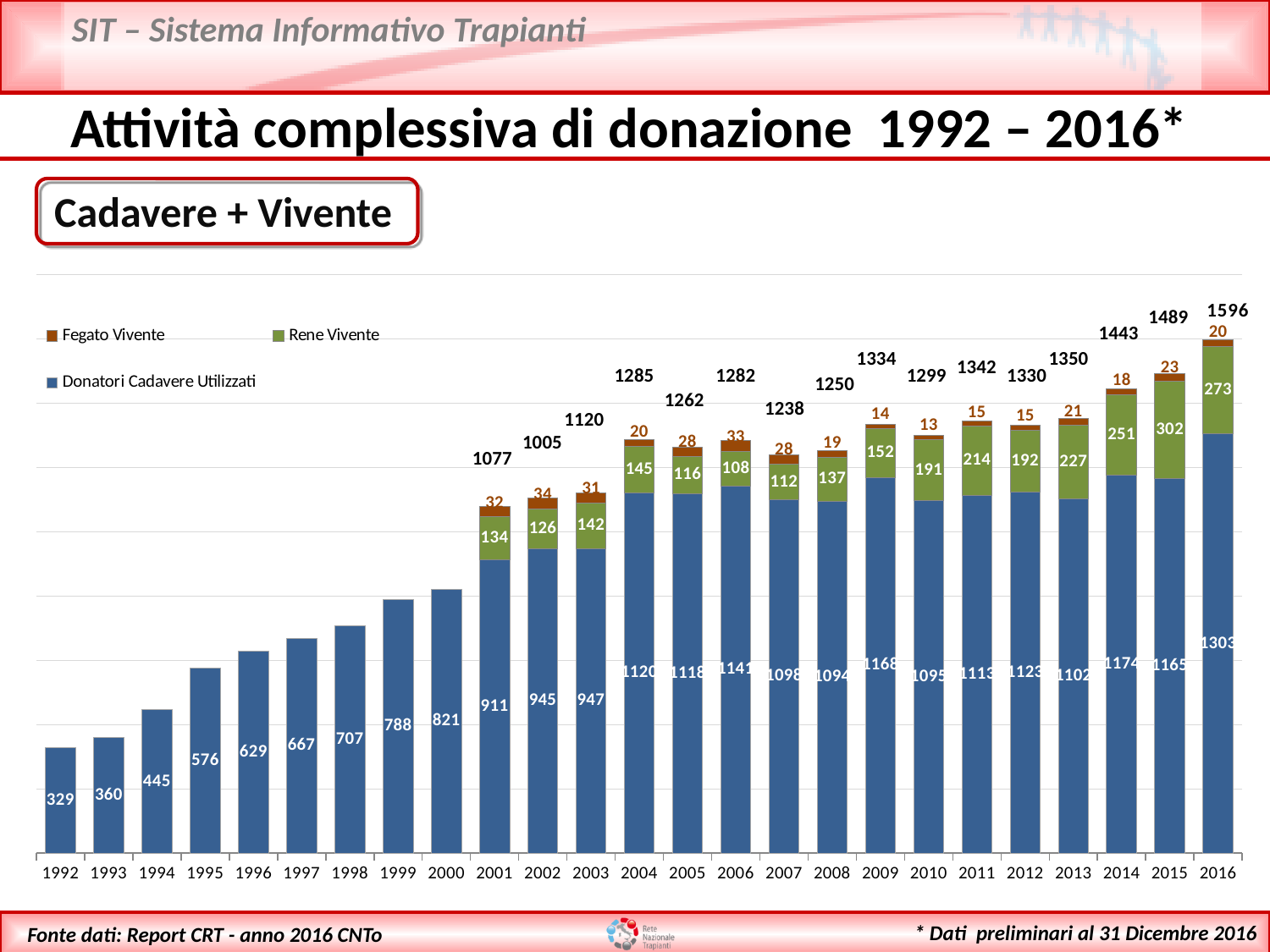
How many years are shown on the x axis? 25 What is the value of Rene Vivente in 2015? 302 What is the difference between the Donatori Cadavere Utilizzati values in 2016 and 2015? 138 Which year has the highest total shown above the bars? 2016 Do the Donatori Cadavere Utilizzati values rise or fall from 1992 to 2000? Rise What is the total shown for the 2014 bar? 1443 What type of chart is shown on the slide? Stacked bar chart Which is larger, the Rene Vivente value in 2014 or in 2016? 2016 What is the value of Fegato Vivente in 2013? 21 What is the value of Donatori Cadavere Utilizzati in 1992? 329 Which year has the lowest value of Donatori Cadavere Utilizzati? 1992 How many series does the legend list? 3